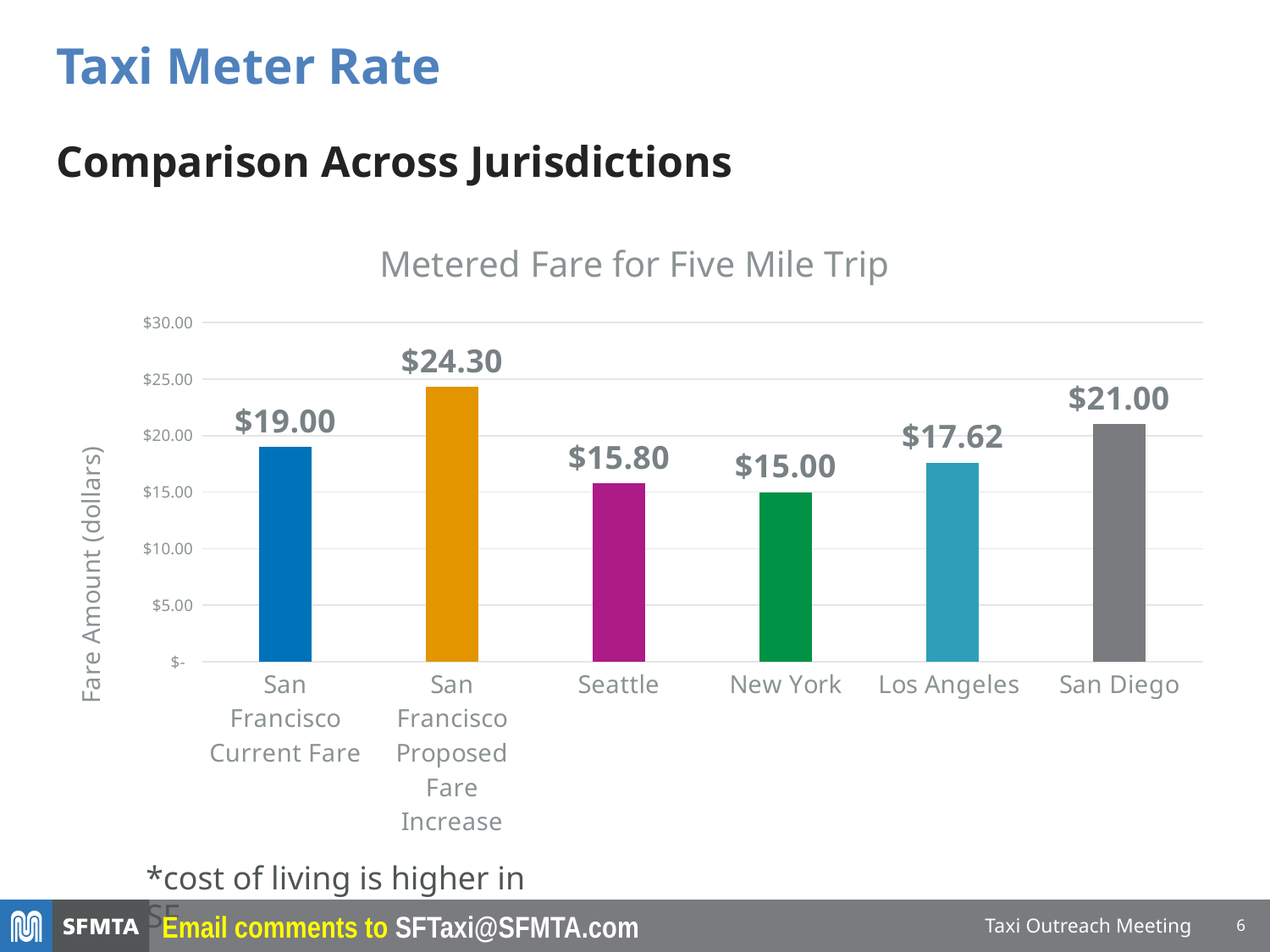
What is the metered fare for a five mile trip in Seattle? $15.80 What is the San Francisco Proposed Fare Increase value for a five mile trip? $24.30 How many categories are shown on the x axis of the chart? 6 What is the title of the chart? Metered Fare for Five Mile Trip Is the value for San Francisco Current Fare greater or less than $20.00? less Which category has the highest metered fare? San Francisco Proposed Fare Increase What is the difference between the San Francisco Proposed Fare Increase and the San Francisco Current Fare? $5.30 Which is larger, the fare for San Diego or the fare for Los Angeles? San Diego What is the difference between the San Diego fare and the New York fare? $6.00 Which city has the lowest metered fare for a five mile trip? New York What is the metered fare for Los Angeles? $17.62 What kind of chart is shown on the slide? bar chart